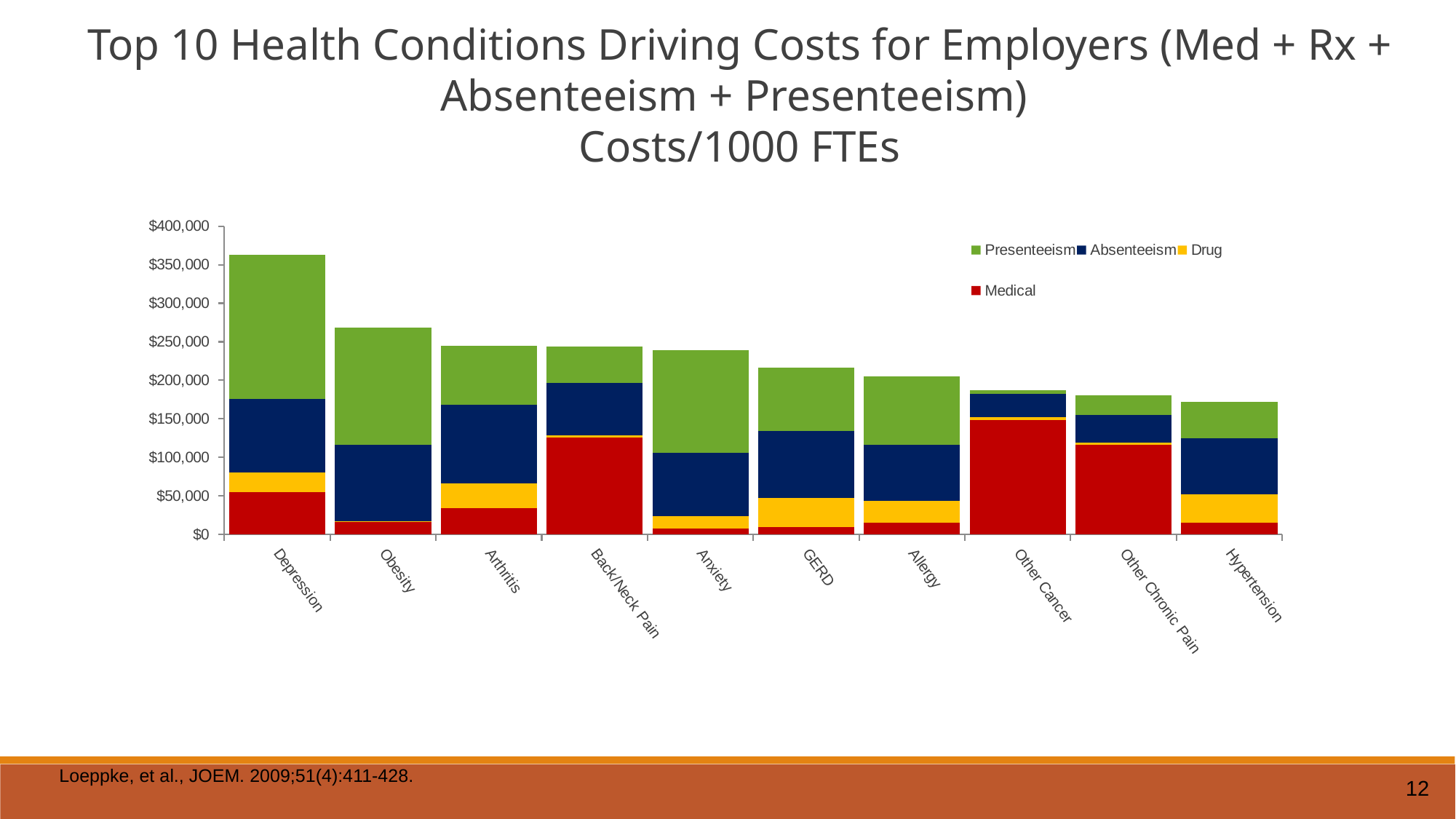
Which health condition has the highest total cost per 1000 FTEs? Depression How many health conditions are plotted along the x axis? 10 How many series does the legend list? 4 Which has a larger Medical cost segment, Other Cancer or Depression? Other Cancer Is the total cost for Depression greater or less than $350,000? greater Do the total costs generally rise or fall moving from left to right along the x axis? fall Is the total cost for Other Cancer greater or less than $200,000? less What kind of chart is shown on the slide? Stacked bar chart Which has a larger total cost, Depression or Obesity? Depression Which health condition has the largest Presenteeism segment? Depression Which colour represents the Medical series in the legend? Red Is the total cost for Obesity greater or less than $250,000? greater